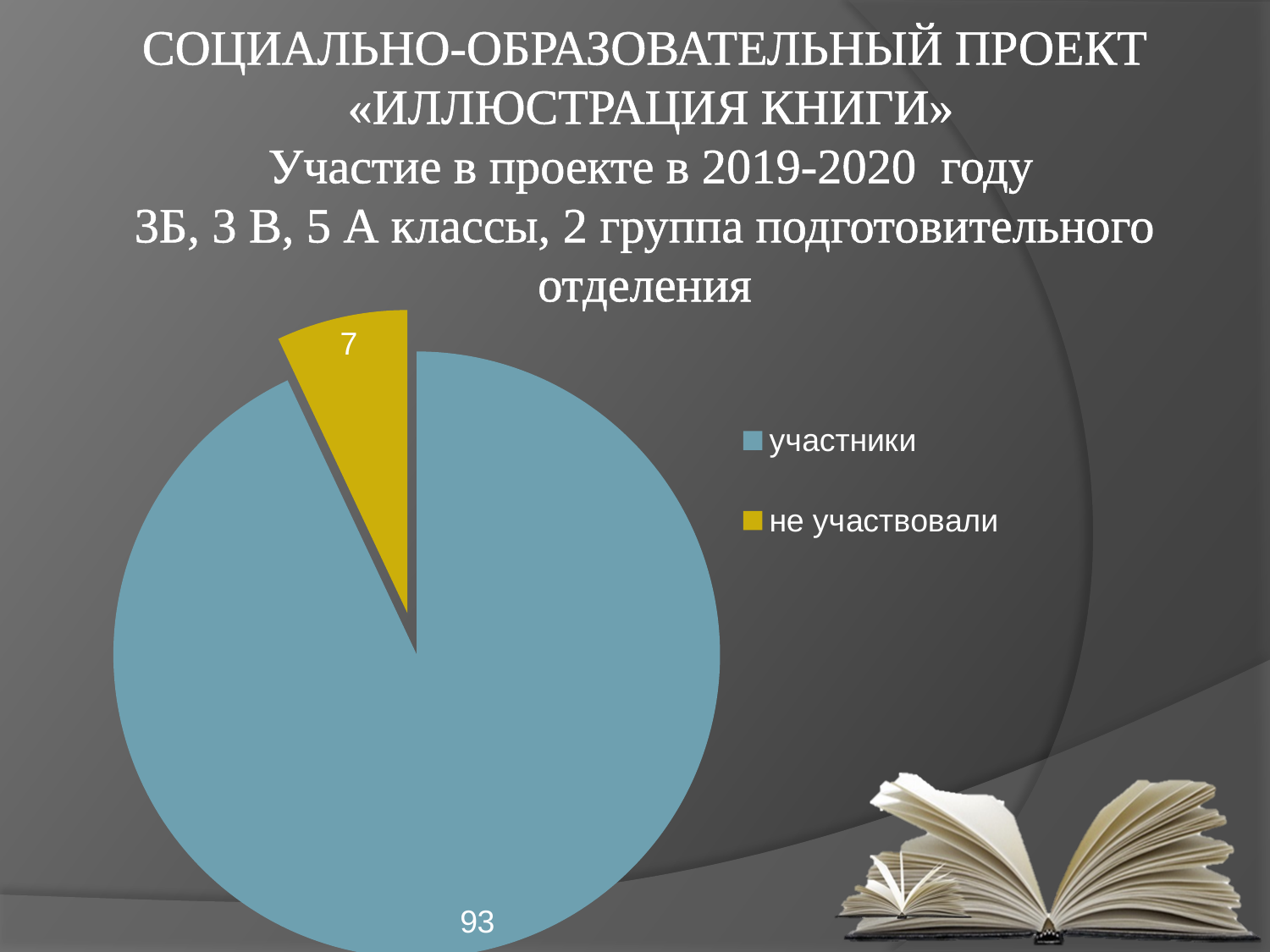
What share of the pie does the участники slice represent? 93% What kind of chart is shown on the slide? pie chart What is the total of the two values shown on the pie chart? 100 What colour is the slice for не участвовали? yellow What is the value for не участвовали? 7 What is the difference between the values for участники and не участвовали? 86 Which category has the smallest slice of the pie? не участвовали How many entries does the legend list? 2 How many slices does the pie chart have? 2 What is the value for участники? 93 Which is larger, the value for участники or the value for не участвовали? участники Which category has the largest slice of the pie? участники